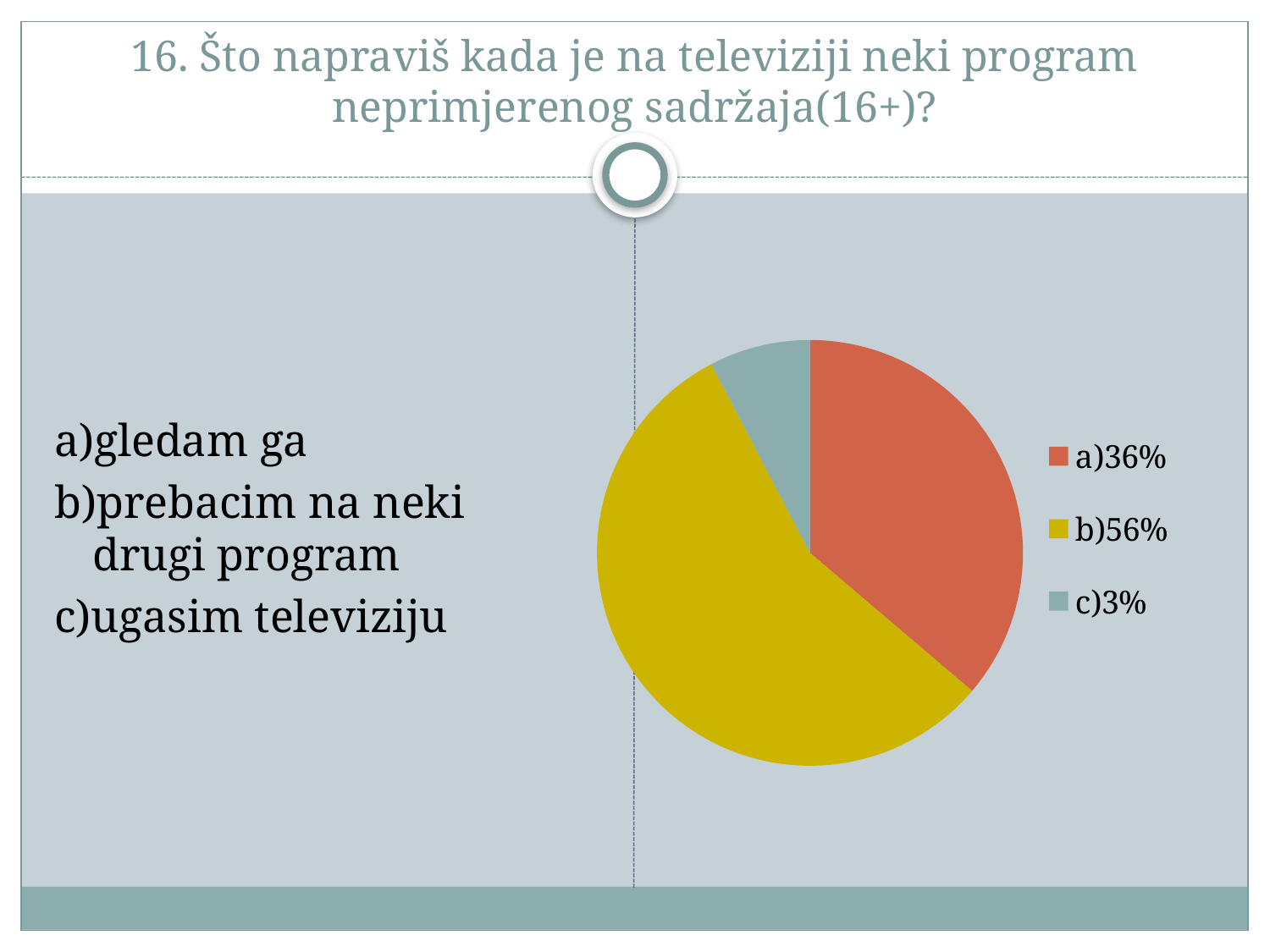
Is the share for option b) greater or less than 50%? greater Which option has the smallest share of the pie? c) What colour is the slice for option b)? yellow What percentage does the legend give for option c)? 3% What percentage does the legend give for option b)? 56% How many slices does the pie chart have? 3 What percentage does the legend give for option a)? 36% Which option has the largest share of the pie? b) What is the difference in percentage points between option b) and option a)? 20 How many entries does the legend list? 3 What kind of chart is shown on the slide? pie chart Which is larger, the share for option a) or the share for option c)? a)